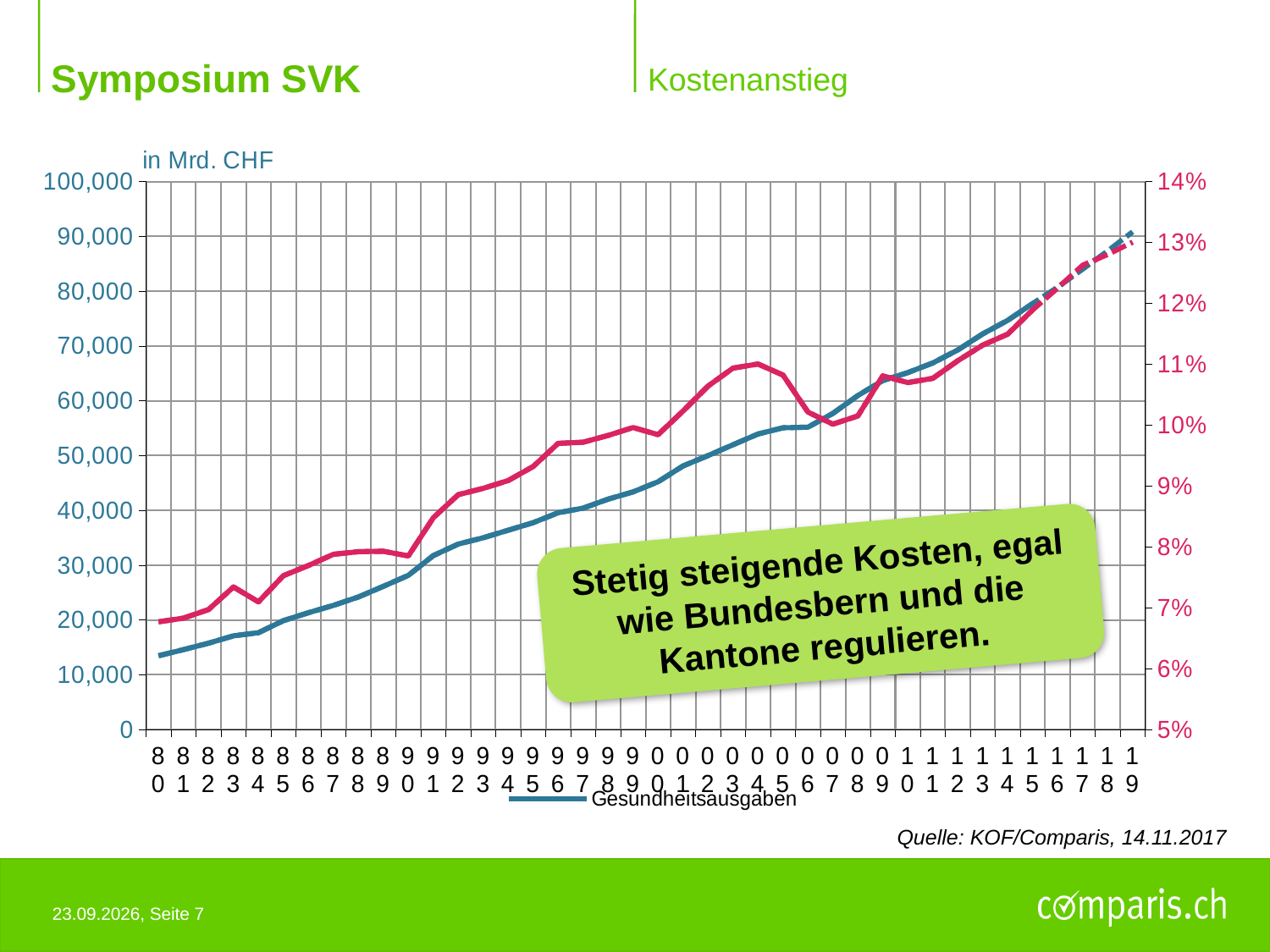
What unit is given for the left axis of the chart? in Mrd. CHF Which series does the legend list? Gesundheitsausgaben Is the value for Gesundheitsausgaben in 00 greater or less than 50,000? less Is the value for Gesundheitsausgaben in 19 greater or less than 80,000? greater In which year are the Gesundheitsausgaben highest? 19 In which year are the Gesundheitsausgaben lowest? 80 Do the Gesundheitsausgaben rise or fall from 80 to 19? rise Is the value for Gesundheitsausgaben in 10 greater or less than 60,000? greater How many years are shown on the x axis? 40 Which year has the larger Gesundheitsausgaben, 90 or 05? 05 What kind of chart is shown on the slide? line chart